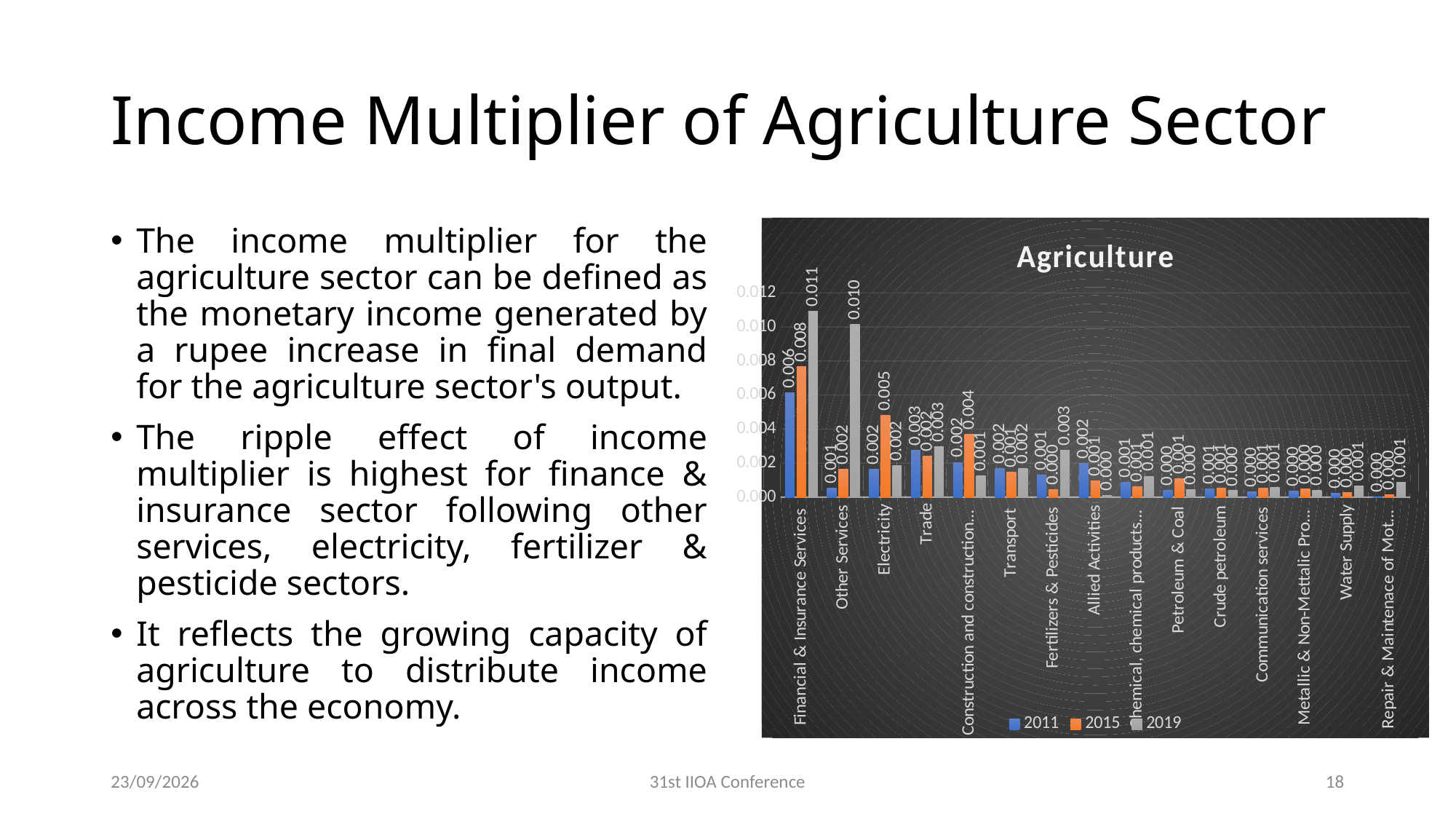
How many categories are shown on the x axis? 15 What is the difference between the 2019 and 2011 values for Financial & Insurance Services? 0.005 How many series does the legend list? 3 What is the title of the chart? Agriculture For Electricity, which is larger: the 2011 value or the 2015 value? 2015 What is the 2019 value for Financial & Insurance Services? 0.011 Is the 2015 value for Electricity greater or less than 0.004? greater Which category has the highest 2019 value? Financial & Insurance Services What is the 2019 value for Other Services? 0.010 What is the 2015 value for Financial & Insurance Services? 0.008 What is the 2015 value for Electricity? 0.005 What kind of chart is shown? Bar chart